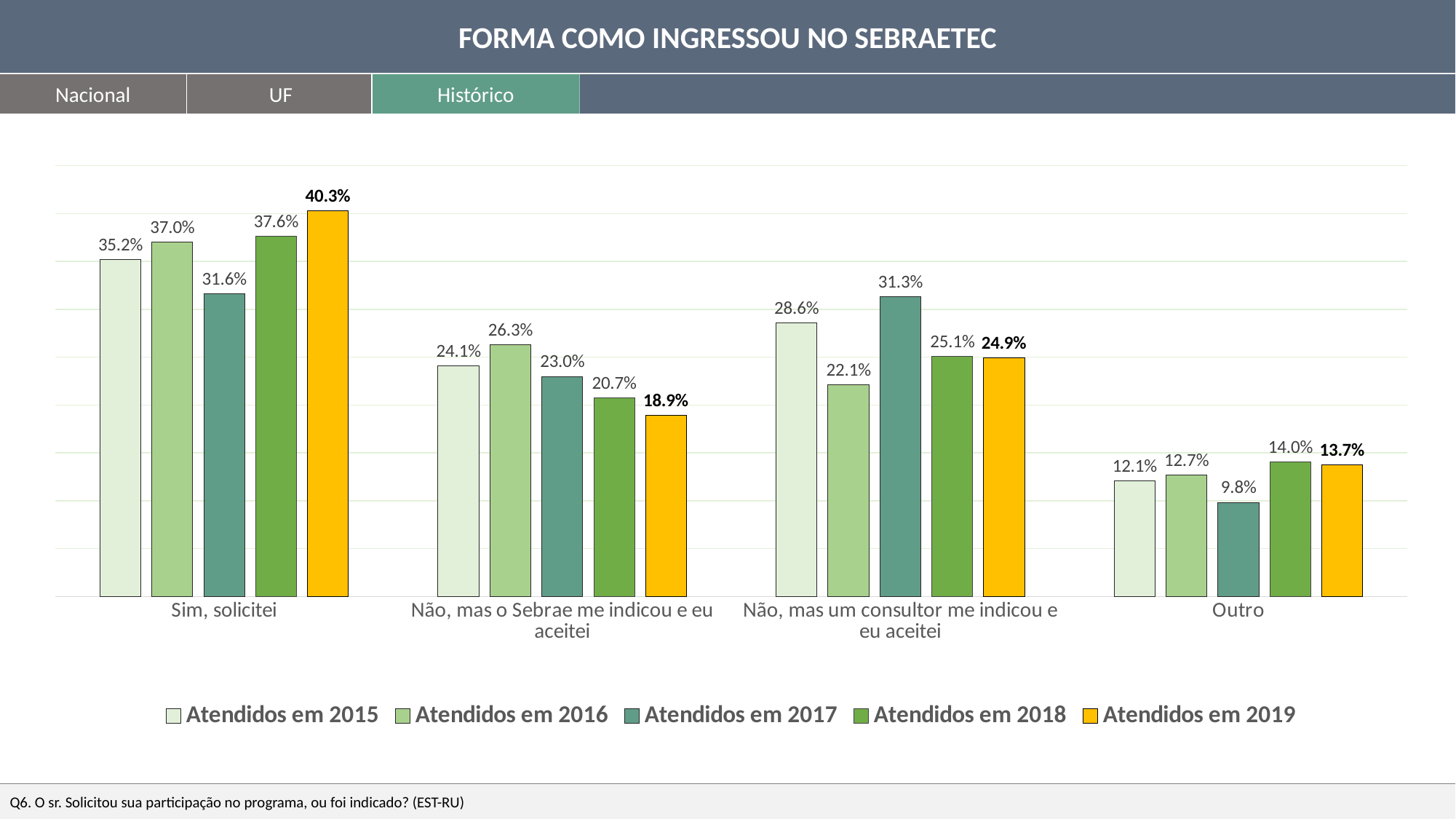
Which is larger in the 'Outro' category: 'Atendidos em 2018' or 'Atendidos em 2019'? Atendidos em 2018 What is the difference between the 'Atendidos em 2019' and 'Atendidos em 2015' values in the 'Sim, solicitei' category? 5.1% What is the value for 'Atendidos em 2019' in the 'Sim, solicitei' category? 40.3% What is the value for 'Atendidos em 2017' in the 'Outro' category? 9.8% How many series does the legend list? 5 What is the title of the slide? FORMA COMO INGRESSOU NO SEBRAETEC What kind of chart is shown on the slide? Bar chart Which series has the lowest value in the 'Não, mas o Sebrae me indicou e eu aceitei' category? Atendidos em 2019 Which series has the highest value in the 'Não, mas um consultor me indicou e eu aceitei' category? Atendidos em 2017 What is the value for 'Atendidos em 2015' in the 'Não, mas um consultor me indicou e eu aceitei' category? 28.6% How many categories are shown on the x axis? 4